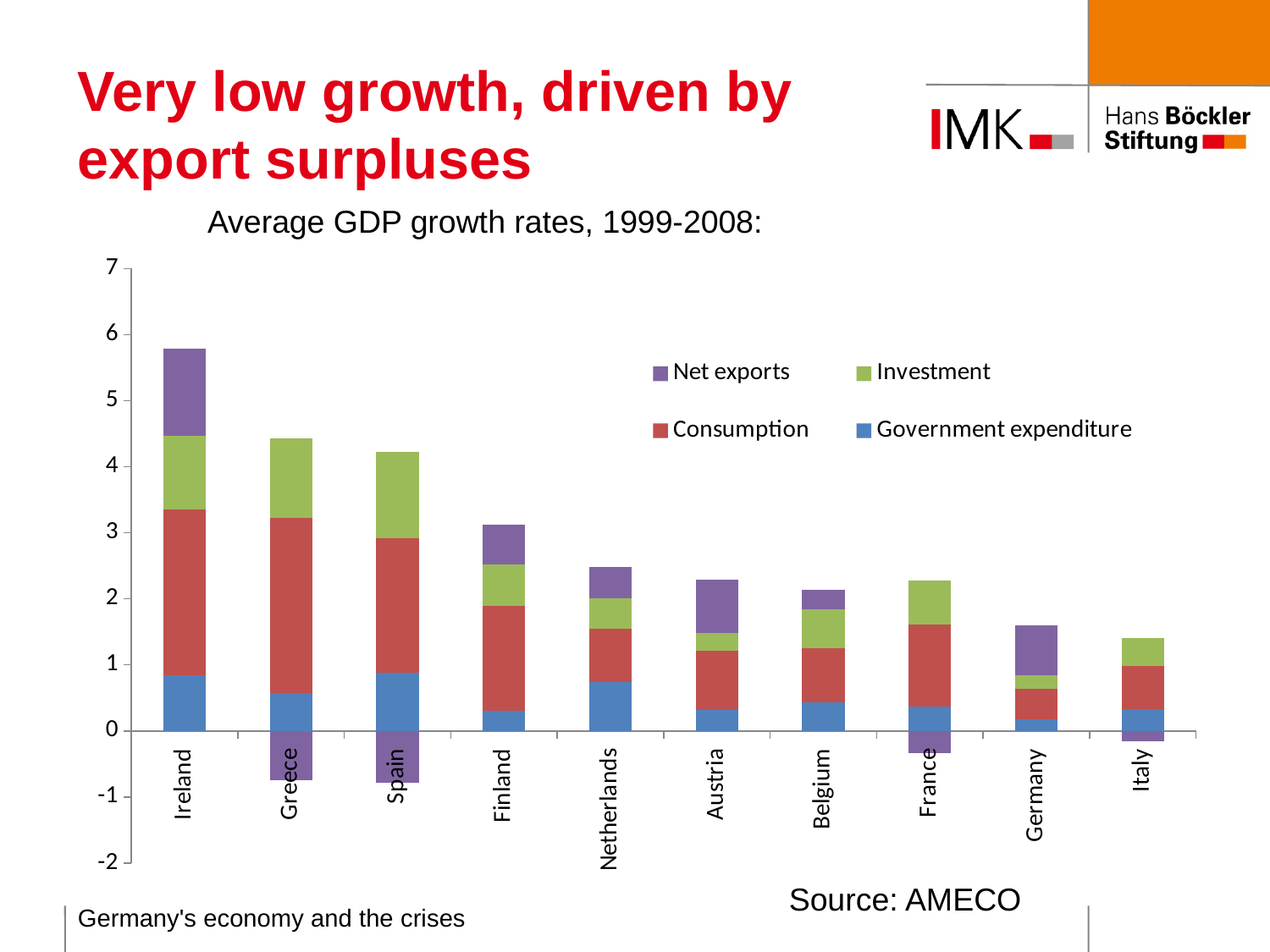
Which country has the largest positive Net exports segment in the chart? Ireland What kind of chart is shown on the slide? Stacked bar chart Which is larger, the Net exports value for Germany or the Net exports value for Spain? Germany Is the top of Ireland's stacked bar greater or less than 5? greater How many countries are shown on the x axis of the chart? 10 Which country has the tallest stacked bar above zero in the chart? Ireland Which series is shown in purple in the chart? Net exports Is the top of Italy's stacked bar greater or less than 2? less Do the heights of the stacked bars above zero generally rise or fall from left to right across the countries? fall Is the Net exports value for Greece greater or less than 0? less What is the title of the chart? Average GDP growth rates, 1999-2008: How many series does the chart's legend list? 4